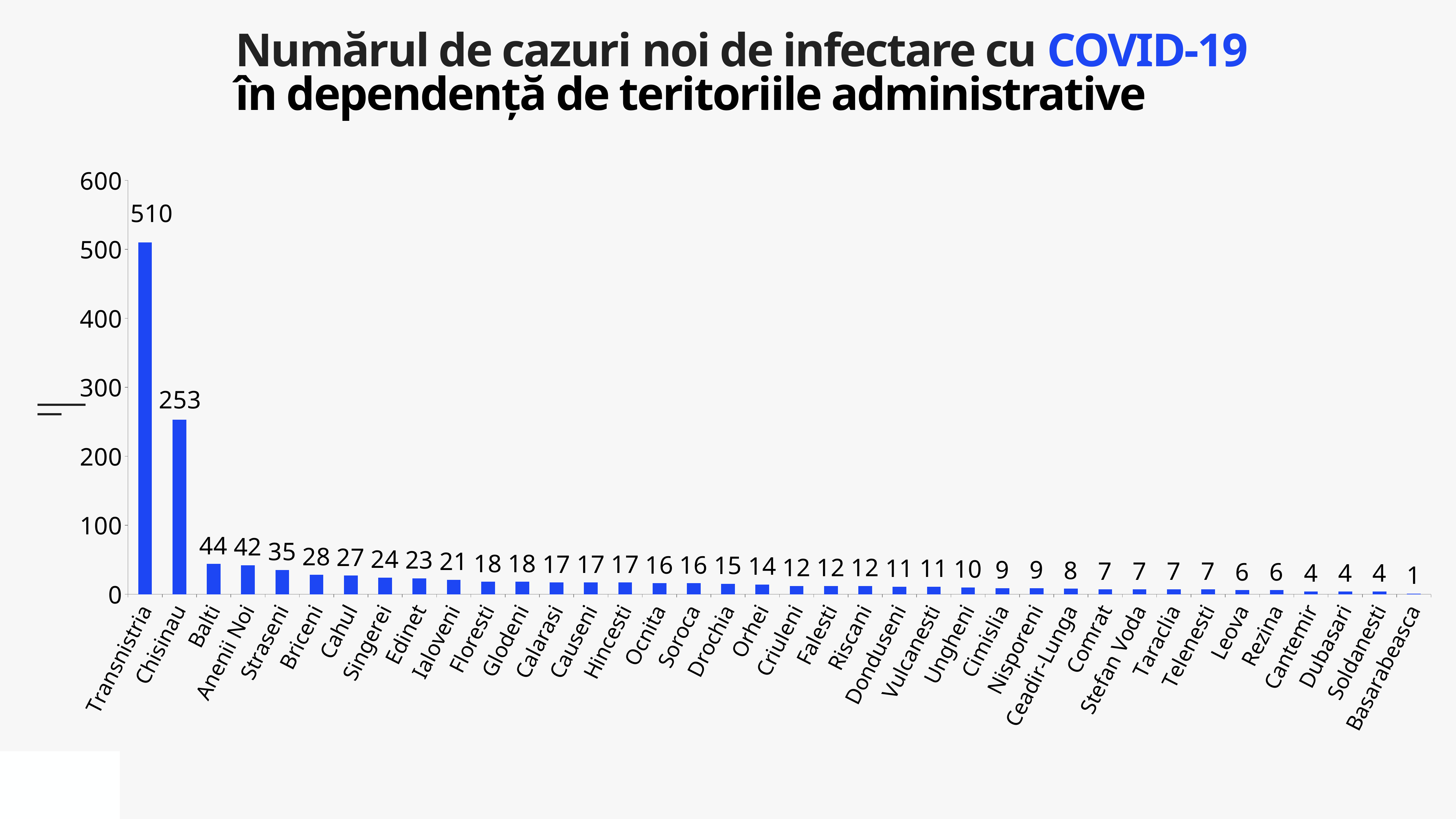
What kind of chart is shown on the slide? bar chart Is the value for Chisinau greater or less than 200? greater Do the values rise or fall from left to right along the x axis? fall How many territories are shown on the x axis? 38 What is the value for Transnistria? 510 What is the value for Chisinau? 253 Which is larger, the value for Straseni or the value for Briceni? Straseni What is the value for Cahul? 27 Which territory has the highest number of new cases? Transnistria What is the value for Balti? 44 Which territory has the lowest number of new cases? Basarabeasca What is the difference between the values for Transnistria and Chisinau? 257